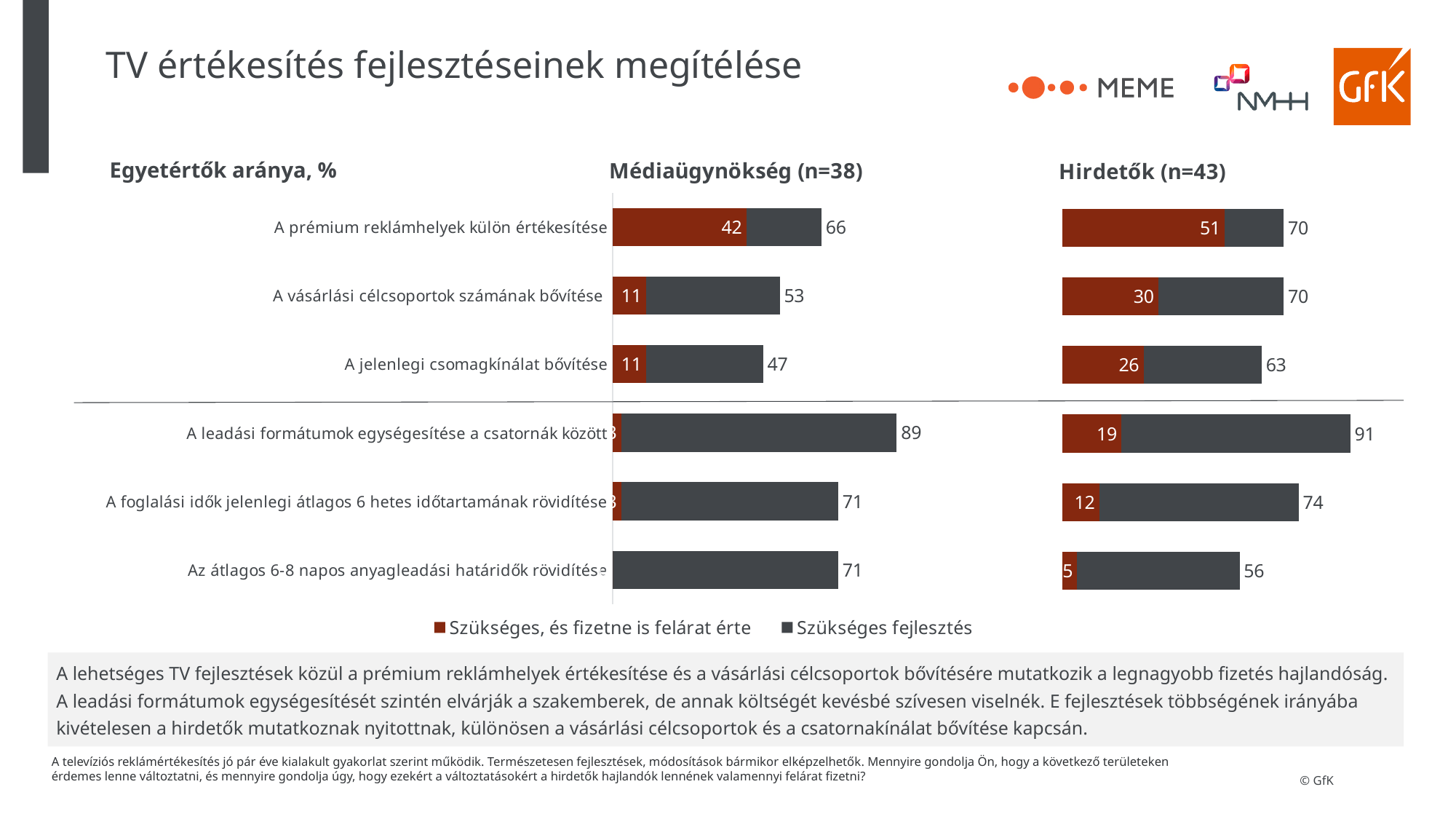
In the Médiaügynökség (n=38) chart, which has the larger end-of-bar value: 'A prémium reklámhelyek külön értékesítése' or 'A vásárlási célcsoportok számának bővítése'? A prémium reklámhelyek külön értékesítése In the Hirdetők (n=43) chart, which category has the lowest 'Szükséges, és fizetne is felárat érte' value? Az átlagos 6-8 napos anyagleadási határidők rövidítése In the Hirdetők (n=43) chart, which category has the highest value at the end of its bar? A leadási formátumok egységesítése a csatornák között In the Hirdetők (n=43) chart, what is the value of the 'Szükséges, és fizetne is felárat érte' segment for 'A prémium reklámhelyek külön értékesítése'? 51 How many categories are shown in the Médiaügynökség (n=38) chart? 6 In the Hirdetők (n=43) chart, what is the difference between the 'Szükséges, és fizetne is felárat érte' values for 'A prémium reklámhelyek külön értékesítése' and 'A vásárlási célcsoportok számának bővítése'? 21 What are the two legend entries shown below the charts? Szükséges, és fizetne is felárat érte; Szükséges fejlesztés In the Hirdetők (n=43) chart, what is the difference between the end-of-bar values for 'A prémium reklámhelyek külön értékesítése' and 'A jelenlegi csomagkínálat bővítése'? 7 How many series does the legend list? 2 What kind of chart is the Hirdetők (n=43) chart? Bar chart In the Médiaügynökség (n=38) chart, what is the value of the 'Szükséges, és fizetne is felárat érte' segment for 'A vásárlási célcsoportok számának bővítése'? 11 In the Médiaügynökség (n=38) chart, what is the value shown at the end of the bar for 'A leadási formátumok egységesítése a csatornák között'? 89